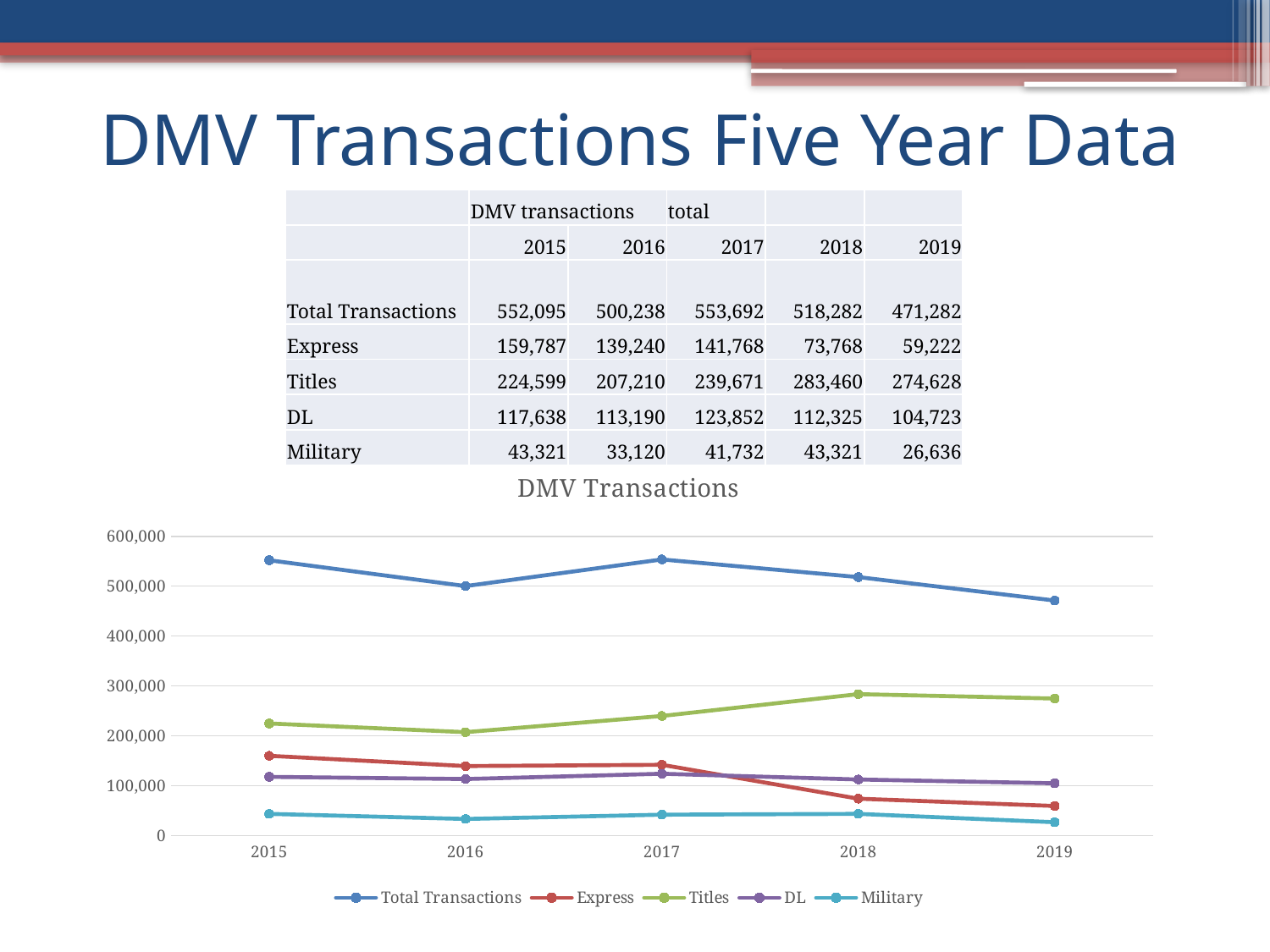
Is the value for Titles in 2019 greater or less than 200,000? greater In which year is Express lowest? 2019 What is the value of Military in 2016? 33,120 What is the value of Express in 2019? 59,222 Which is larger in 2018, Express or DL? DL Does the Express series rise or fall from 2015 to 2019? fall What is the difference between Total Transactions in 2015 and 2019? 80,813 How many series does the legend of the DMV Transactions chart list? 5 What is the value of Titles in 2018? 283,460 In which year is Total Transactions highest? 2017 What kind of chart is shown on the slide? line chart How many years are plotted along the x axis of the DMV Transactions chart? 5